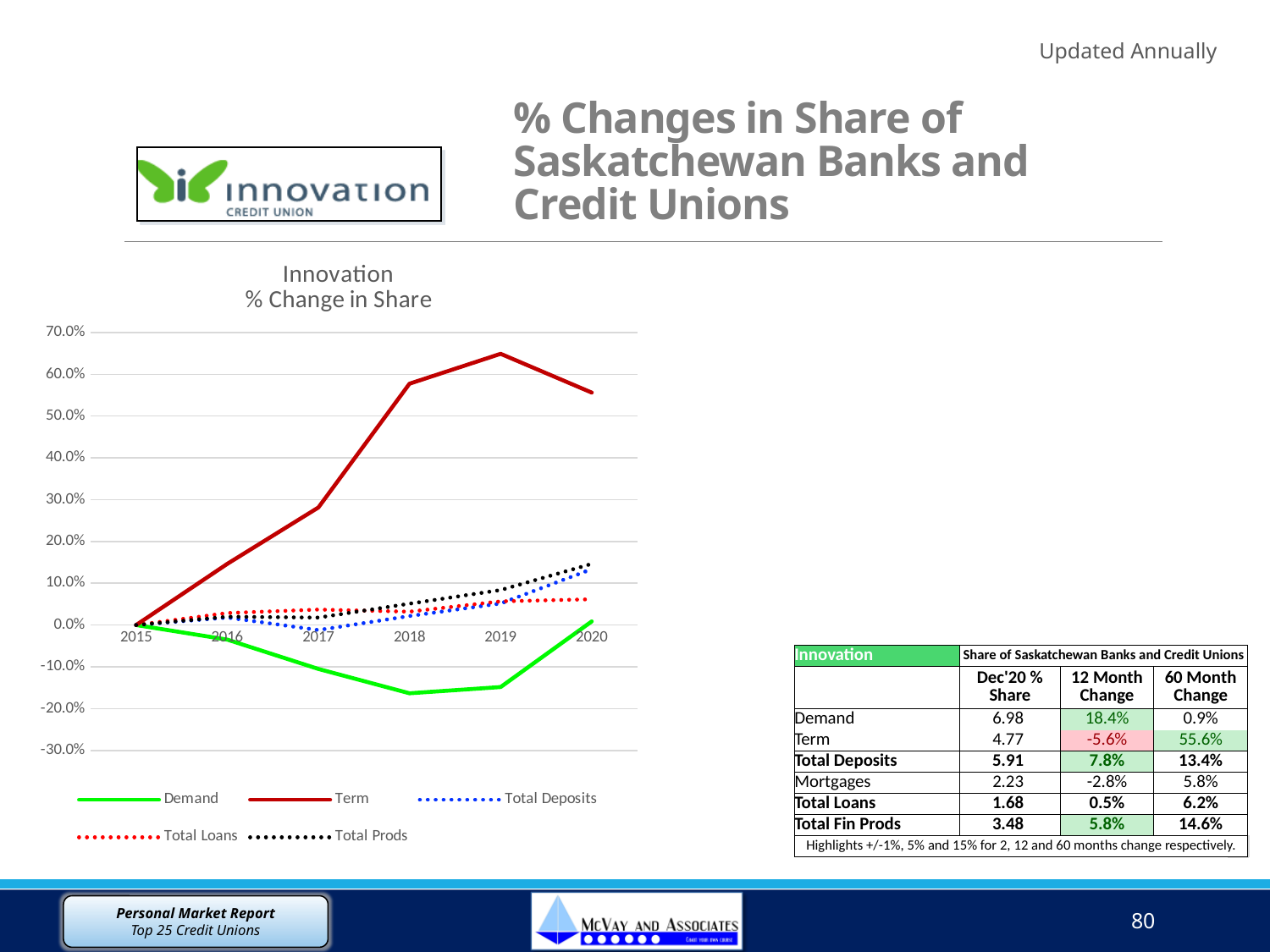
What is the title of the chart? Innovation % Change in Share Which series has the highest value in 2020? Term Which series has the lowest value in 2018? Demand Is the value for Demand in 2018 greater or less than -10.0%? less What kind of chart is shown on the slide? line chart In which year does the Term series reach its peak? 2019 Does the Term series rise or fall from 2015 to 2019? rise Is the value for Term in 2017 greater or less than 20.0%? greater Is the value for Term in 2019 greater or less than 60.0%? greater Which is larger in 2020, the value for Term or the value for Demand? Term How many years are plotted along the x axis of the chart? 6 How many series does the chart legend list? 5